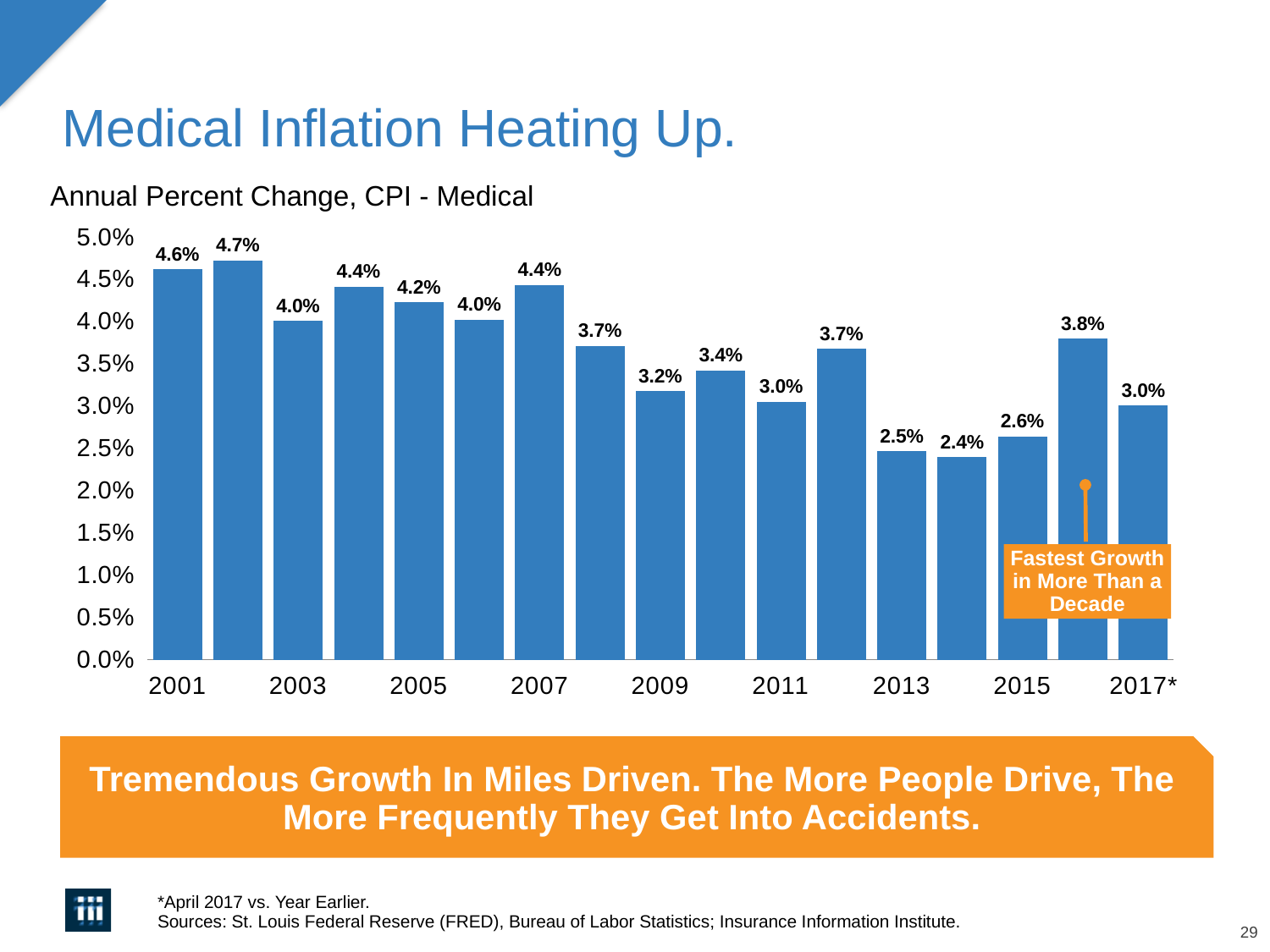
Which is larger, the value for 2009 or the value for 2015? 2009 What is the difference between the values for 2001 and 2011? 1.6% What does the orange callout on the chart say about the 2016 bar? Fastest Growth in More Than a Decade Which year has the highest annual percent change in the chart? 2002 Which year has the lowest annual percent change in the chart? 2014 What is the value shown for 2007? 4.4% Is the value for 2005 greater or less than 4.0%? greater What is the annual percent change in CPI - Medical for 2001? 4.6% How many bars are plotted in the chart? 17 What is the value shown for 2017*? 3.0% What is the value shown for 2013? 2.5% What type of chart is shown on the slide? Bar chart